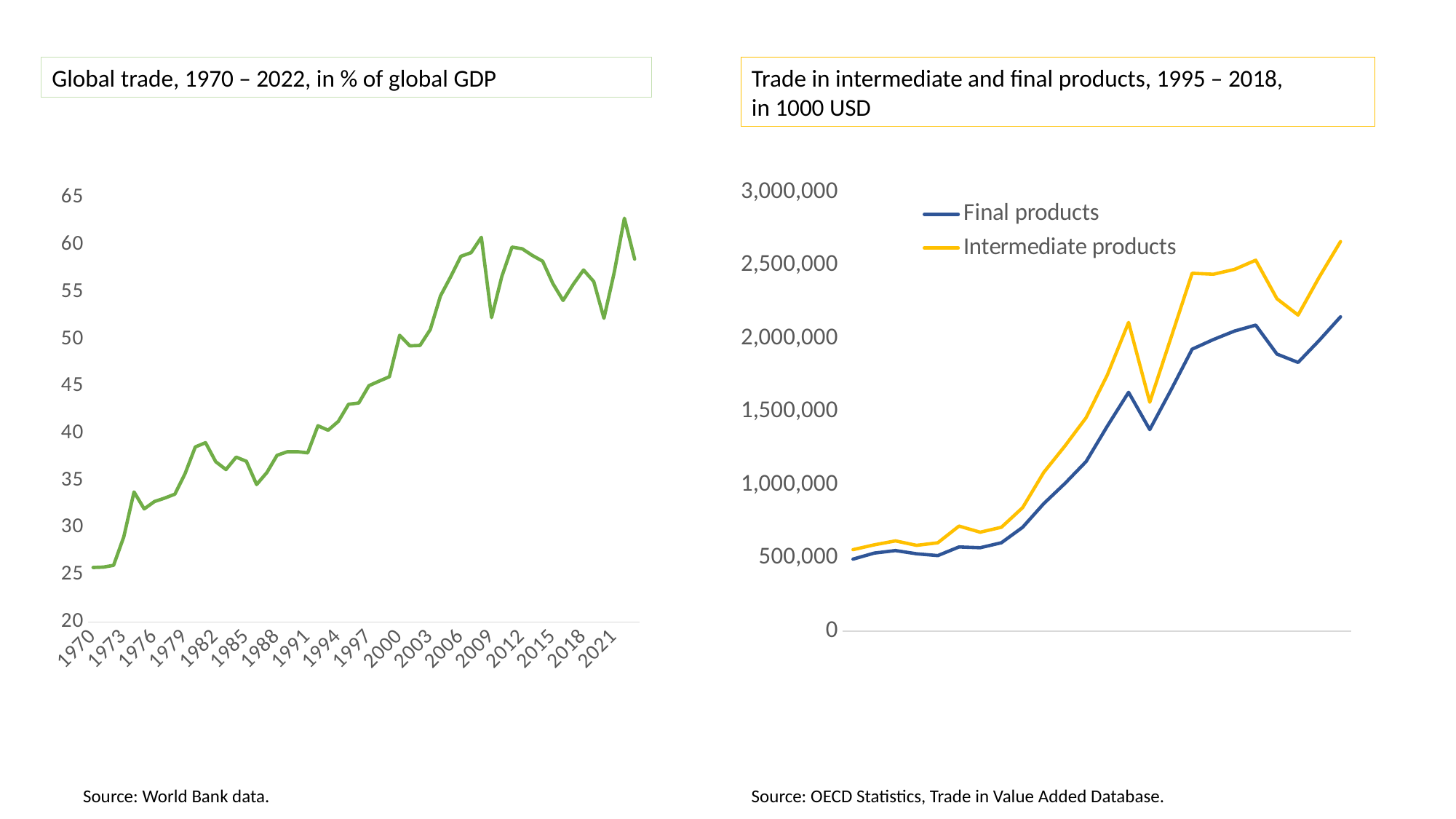
In the 'Trade in intermediate and final products' chart, which series is plotted in yellow? Intermediate products In the 'Trade in intermediate and final products' chart, is the highest value of Final products greater or less than 2,500,000? less How many series does the legend of the 'Trade in intermediate and final products' chart list? 2 In the 'Global trade, 1970 – 2022' chart, do the values generally rise or fall from 1970 to 2022? rise In the 'Global trade, 1970 – 2022' chart, is the value for 1970 greater or less than 30? less What kind of chart is the 'Global trade, 1970 – 2022, in % of global GDP' chart? line chart In the 'Global trade, 1970 – 2022' chart, is the value for 2006 greater or less than 55? greater What is the title of the chart on the left of the slide? Global trade, 1970 – 2022, in % of global GDP In the 'Trade in intermediate and final products' chart, do the values generally rise or fall from left to right? rise What kind of chart is the 'Trade in intermediate and final products, 1995 – 2018, in 1000 USD' chart? line chart In the 'Trade in intermediate and final products' chart, which series has the higher values throughout, Final products or Intermediate products? Intermediate products